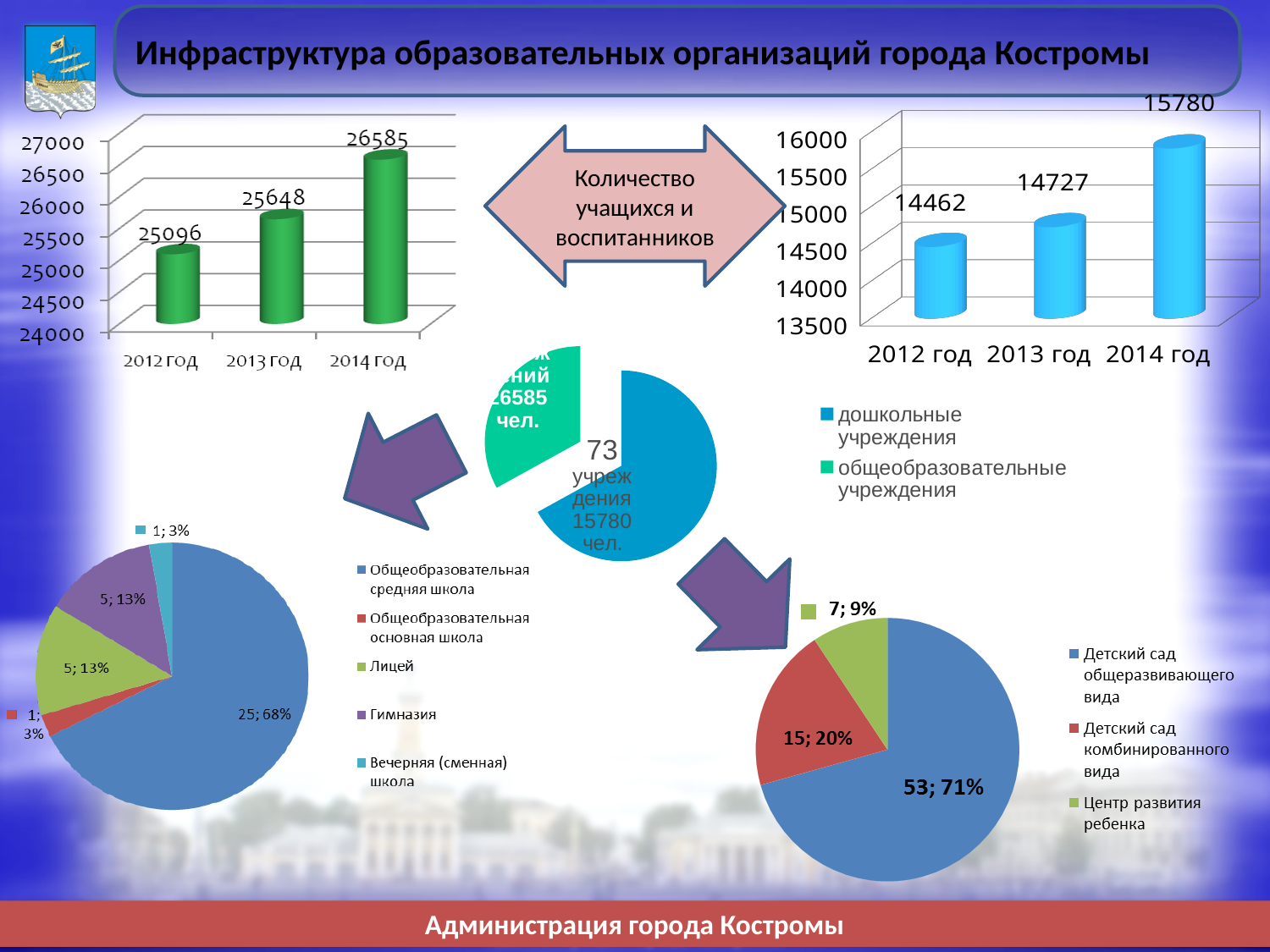
In the top-left bar chart, what is the value for 2014 год? 26585 In the top-left bar chart, do the values rise or fall from 2012 год to 2014 год? rise In the top-right bar chart, what is the value for 2013 год? 14727 In the bottom-right pie chart, which category has the smallest share? Центр развития ребенка In the bottom-left pie chart, what share does Общеобразовательная средняя школа have? 68% In the top-right bar chart, what is the difference between the 2014 год and 2013 год values? 1053 How many bars are in the top-right bar chart? 3 How many entries does the legend of the bottom-left pie chart list? 5 In the top-left bar chart, what is the value for 2012 год? 25096 In the bottom-right pie chart, what is the value for Детский сад комбинированного вида? 15 In the top-left bar chart, what is the difference between the 2014 год and 2012 год values? 1489 In the top-right bar chart, which year has the highest value? 2014 год